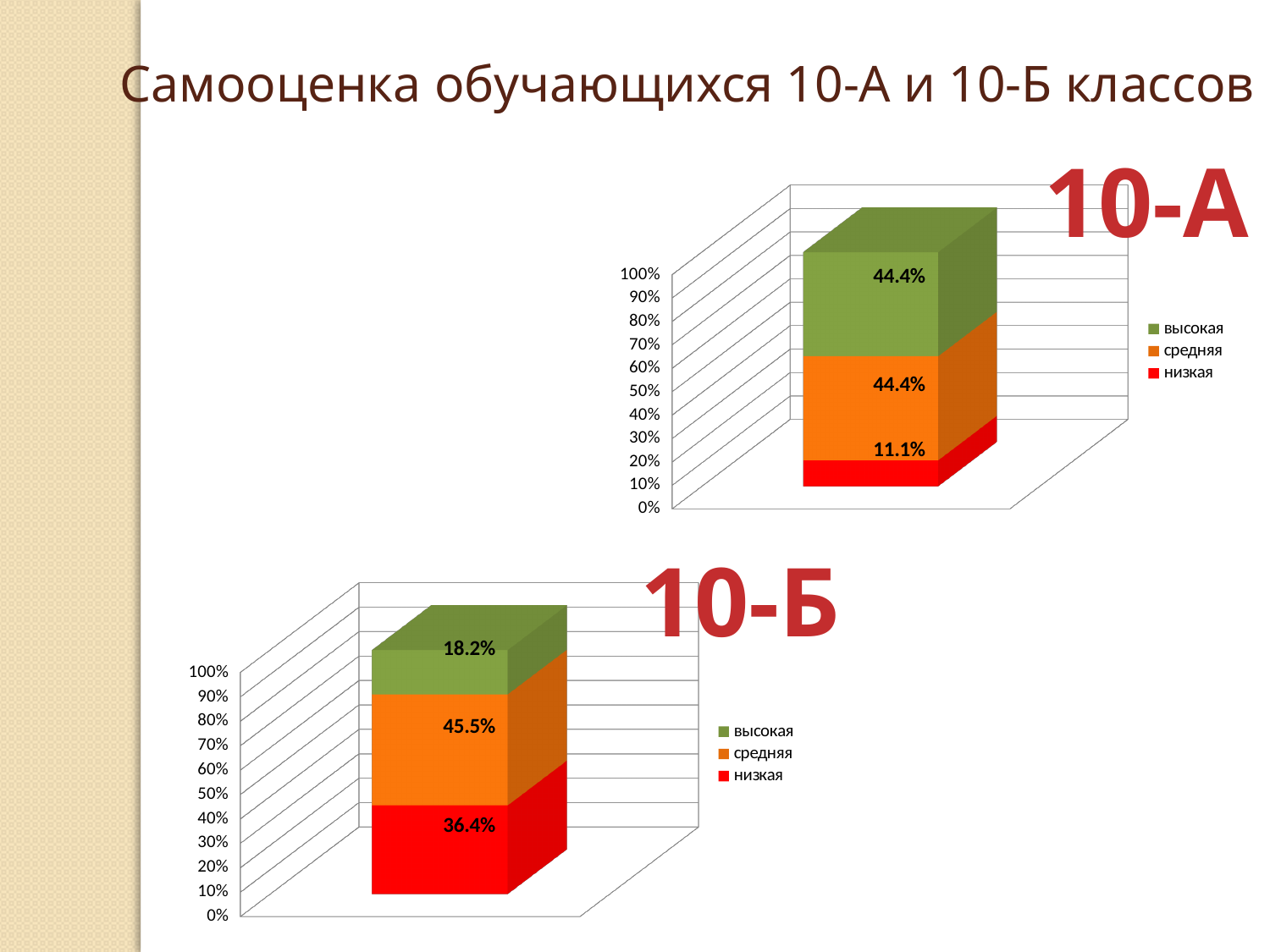
In the 10-Б chart, what is the value for средняя? 45.5% What kind of chart is the 10-Б chart? Stacked bar chart In the 10-Б chart, what is the difference between средняя and высокая? 27.3% In the 10-А chart, what is the difference between высокая and низкая? 33.3% In the 10-Б chart, which series has the smallest share? высокая How many series does the legend of the 10-А chart list? 3 In the 10-А chart, what is the value for высокая? 44.4% In the 10-А chart, what is the value for низкая? 11.1% In the 10-Б chart, which series has the largest share? средняя In the 10-Б chart, what is the value for низкая? 36.4% In the 10-А chart, which series has the smallest share? низкая Which class has the larger value for низкая, 10-А or 10-Б? 10-Б